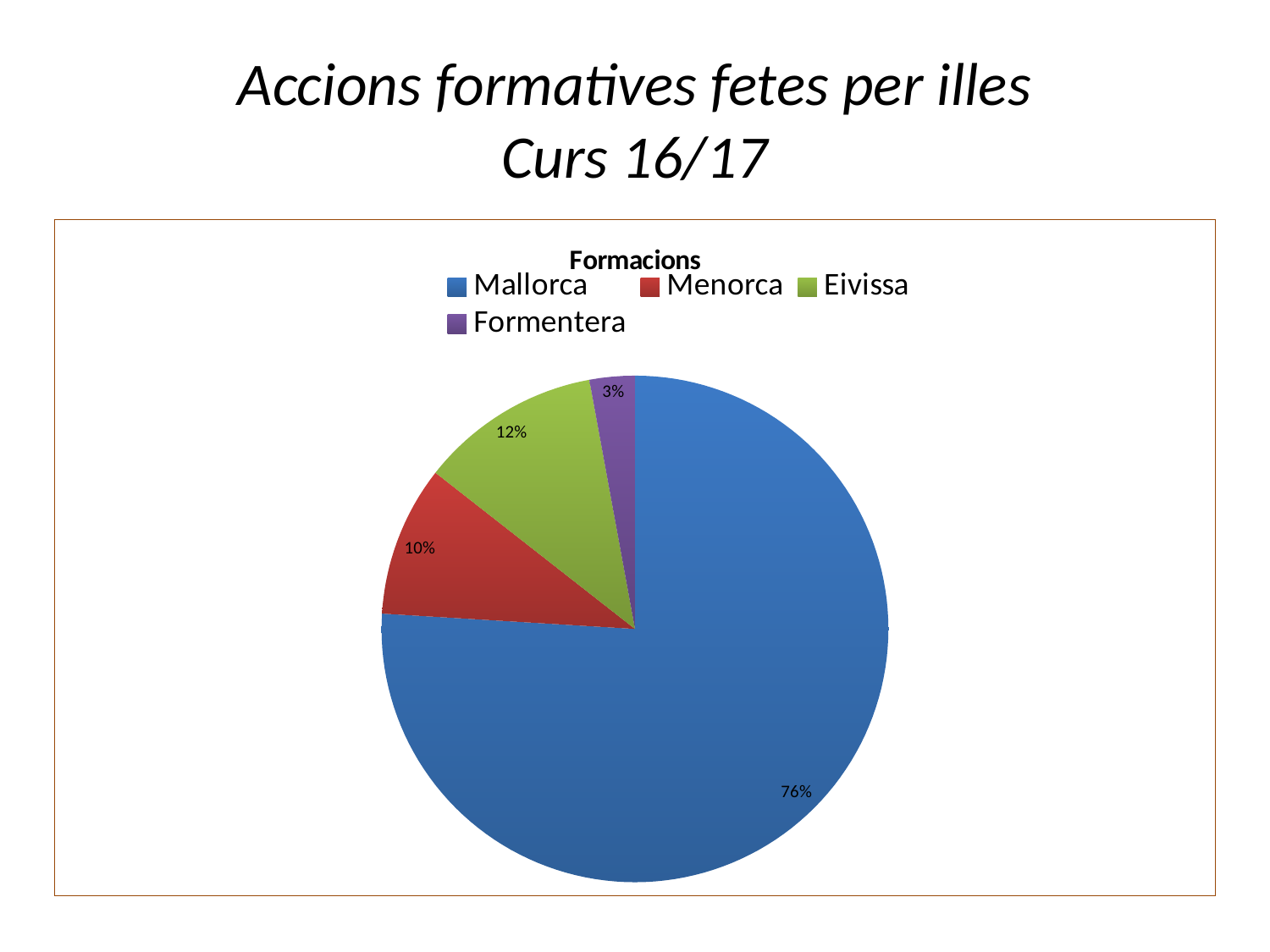
What type of chart is shown on the slide? pie chart What share of the pie does Formentera have? 3% Which island has the smallest slice of the pie? Formentera What share of the pie does Mallorca have? 76% Which island has the largest slice of the pie? Mallorca What share of the pie does Eivissa have? 12% What is the difference in percentage points between the shares of Mallorca and Eivissa? 64 How many slices does the pie chart have? 4 Which is larger, the share for Eivissa or the share for Menorca? Eivissa What is the title of the chart? Formacions What colour is the slice for Menorca? red